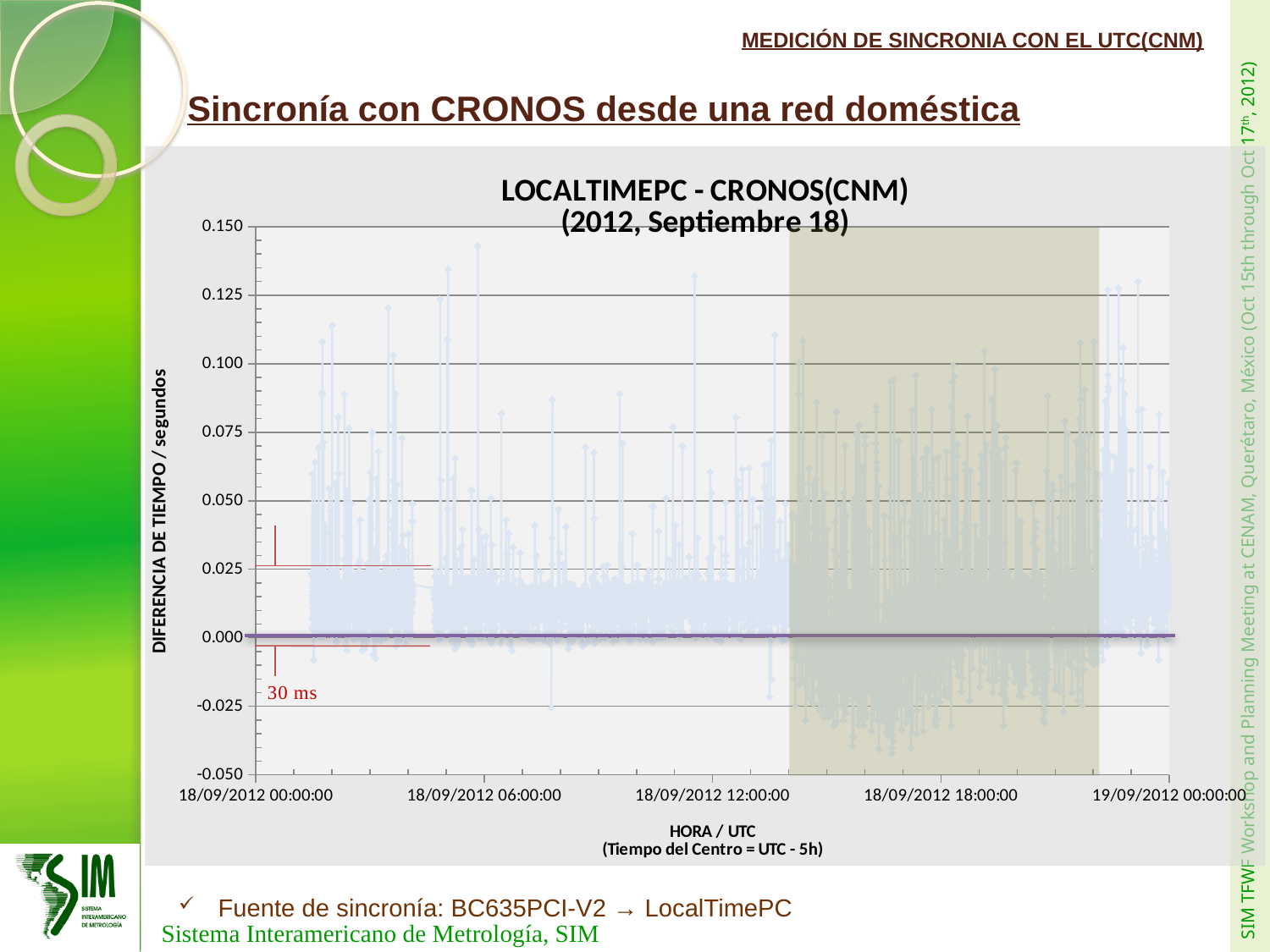
What is the label of the vertical axis of the chart? DIFERENCIA DE TIEMPO / segundos Is the lowest plotted value in the chart greater or less than -0.050? greater What kind of chart is shown on the slide? line chart What is the maximum value shown on the vertical axis of the chart? 0.150 Is the highest plotted value in the chart greater or less than 0.150? less Is the highest plotted value in the chart greater or less than 0.125? greater How many labelled tick marks are shown on the horizontal axis of the chart? 5 What is the minimum value shown on the vertical axis of the chart? -0.050 What is the title of the chart? LOCALTIMEPC - CRONOS(CNM) (2012, Septiembre 18)